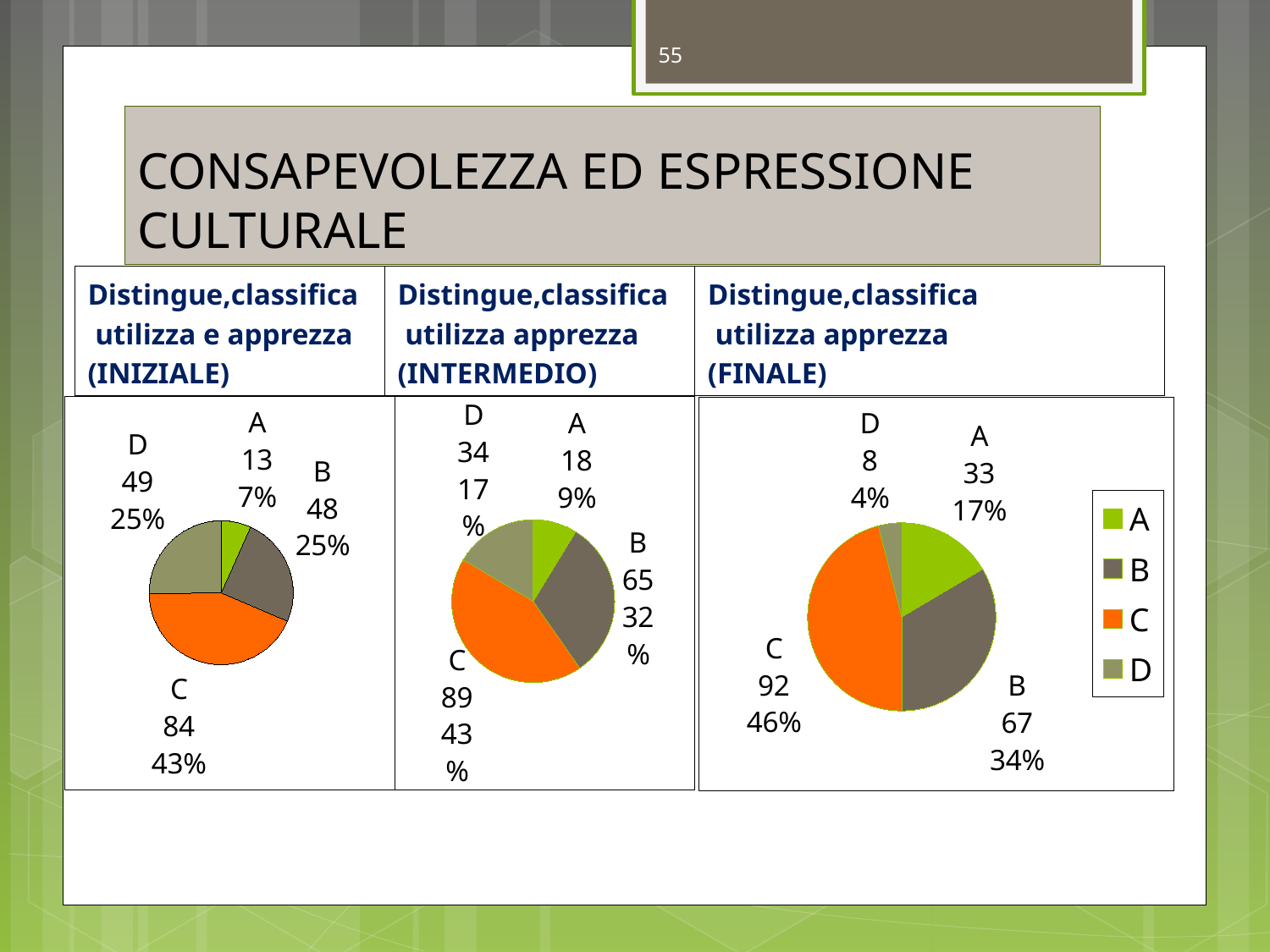
In the INIZIALE pie chart, what percentage share does category A have? 7% What type of chart is used on this slide? Pie chart In the INTERMEDIO pie chart, what is the value for category B? 65 In the INIZIALE pie chart, what is the value for category C? 84 In the INTERMEDIO pie chart, what percentage share does category D have? 17% In the FINALE pie chart, what percentage share does category B have? 34% In the INTERMEDIO pie chart, which category has the smallest value? A In the FINALE pie chart, which category has the smallest value? D In the FINALE pie chart, what is the value for category C? 92 In the INIZIALE pie chart, which is larger, the value for B or the value for A? B In the INIZIALE pie chart, which category has the largest value? C In the FINALE pie chart, what is the difference between the values for C and B? 25